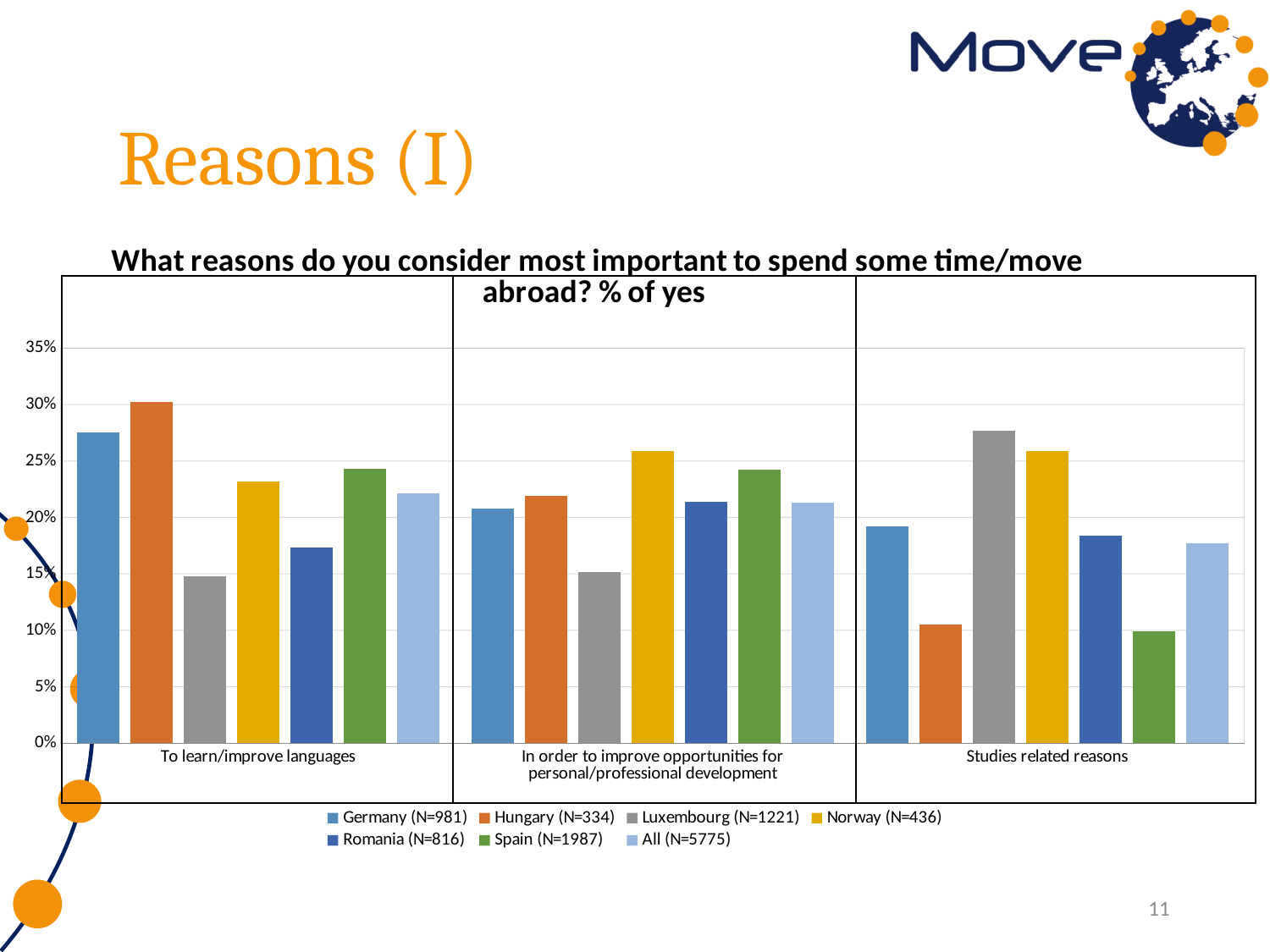
How many reason categories are shown along the x axis? 3 What kind of chart is shown on the slide? bar chart Is the value for Hungary under 'To learn/improve languages' greater or less than 25%? greater What sample size (N) does the legend give for Spain? 1987 Under 'In order to improve opportunities for personal/professional development', which is larger: Norway or Luxembourg? Norway (N=436) For 'To learn/improve languages', which country has the lowest bar? Luxembourg (N=1221) For 'In order to improve opportunities for personal/professional development', which country has the lowest bar? Luxembourg (N=1221) Is the value for Luxembourg under 'To learn/improve languages' greater or less than 20%? less For 'Studies related reasons', which country has the highest bar? Luxembourg (N=1221) Is the value for Hungary under 'Studies related reasons' greater or less than 15%? less How many series does the legend list? 7 For 'To learn/improve languages', which country has the highest bar? Hungary (N=334)